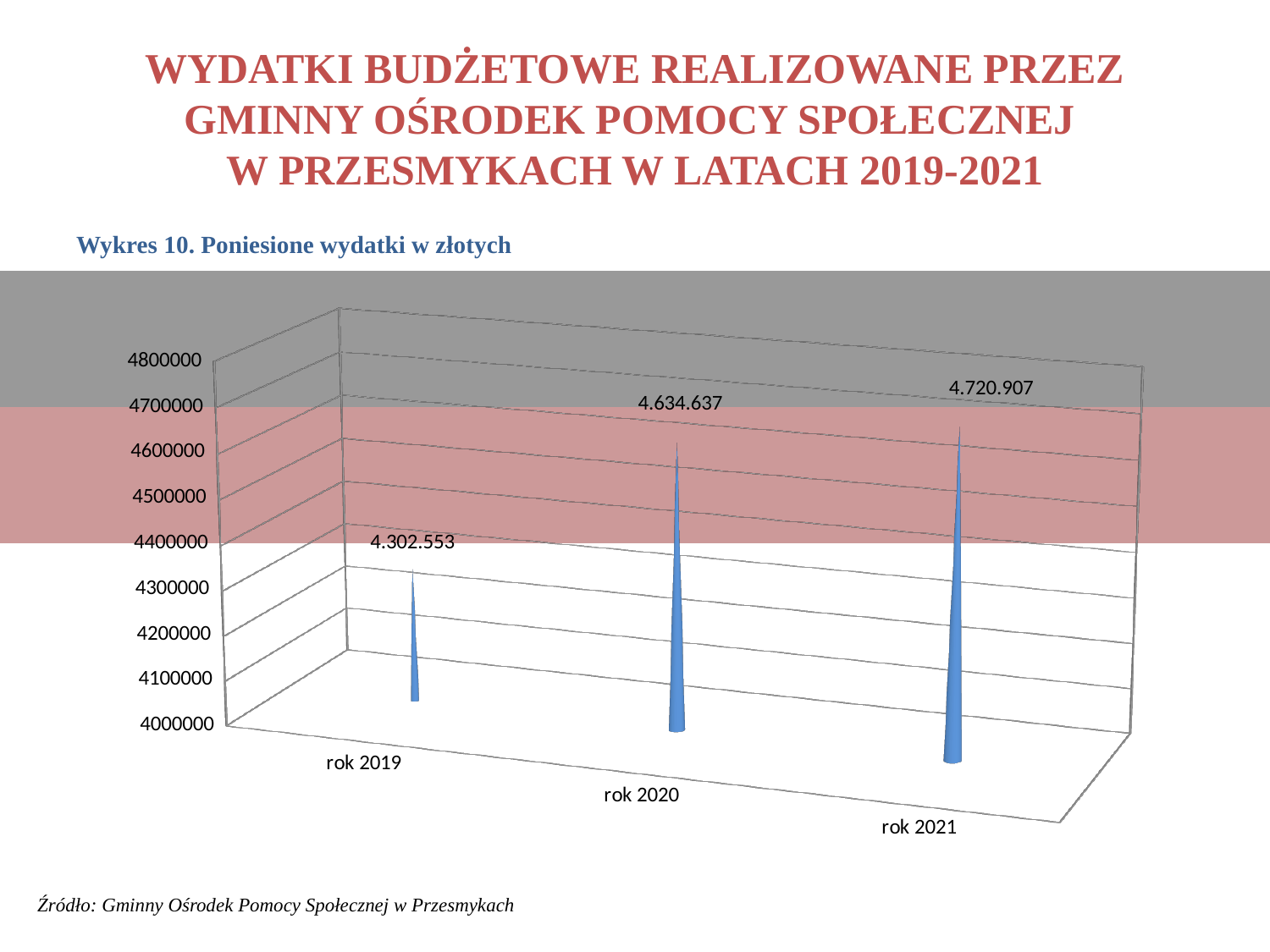
What is the value for rok 2020? 4.634.637 What kind of chart is shown? bar chart Which year has the lowest value? rok 2019 What is the difference between the values for rok 2020 and rok 2019? 332.084 Do the values rise or fall from rok 2019 to rok 2021? rise What is the difference between the values for rok 2021 and rok 2020? 86.270 Is the value for rok 2019 greater or less than 4400000? less Which is larger, the value for rok 2019 or the value for rok 2020? rok 2020 What is the value for rok 2021? 4.720.907 How many years are shown on the chart? 3 Which year has the highest value? rok 2021 What is the value for rok 2019? 4.302.553